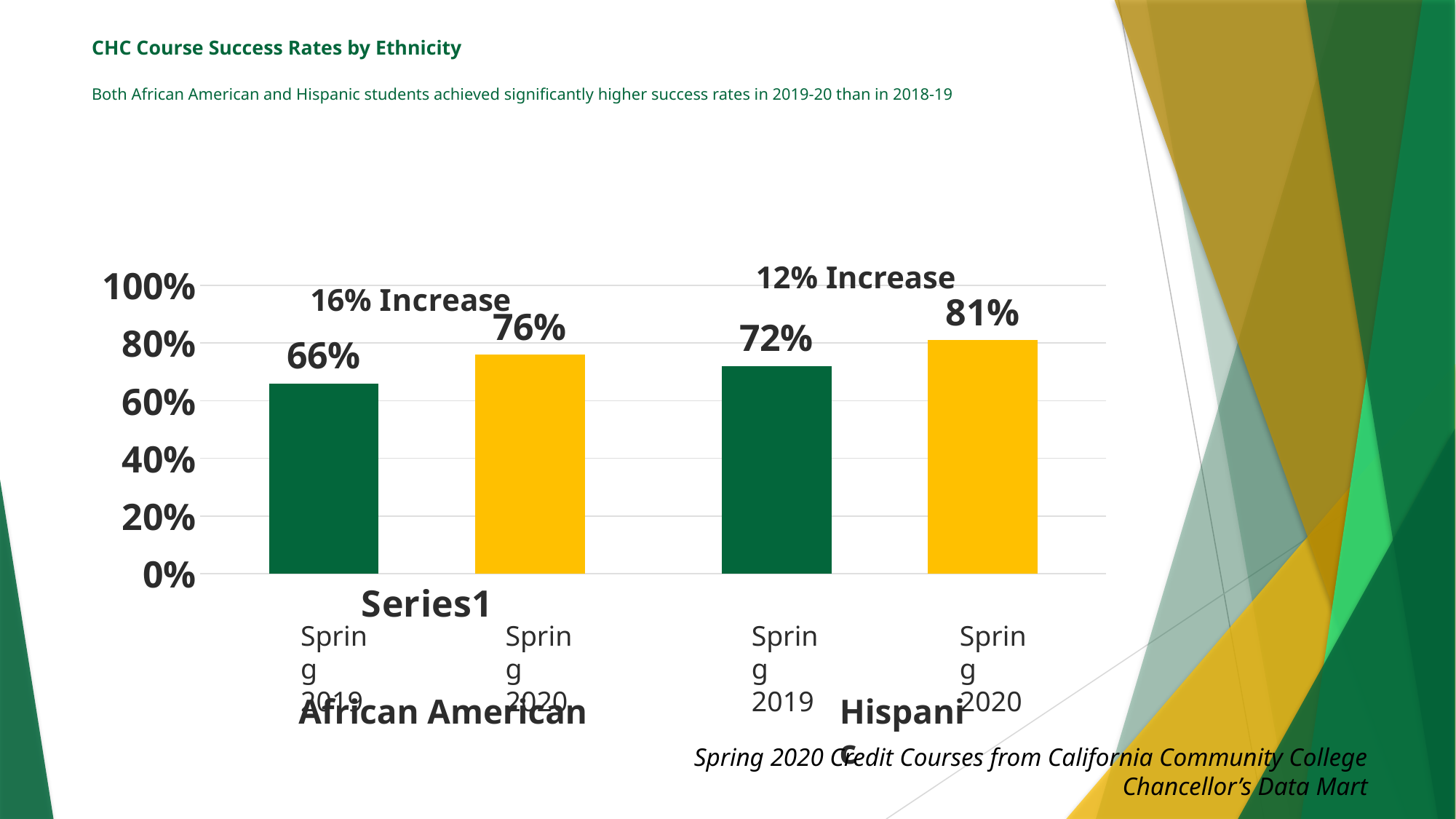
Which bar shows the highest success rate? Hispanic Spring 2020 How many bars are plotted in the chart? 4 What is the difference in percentage points between the African American Spring 2020 rate and the African American Spring 2019 rate? 10 What is the difference in percentage points between the Hispanic Spring 2020 rate and the Hispanic Spring 2019 rate? 9 What is the course success rate for African American students in Spring 2020? 76% What increase is annotated above the African American bars? 16% Increase What kind of chart is shown on the slide? Bar chart What is the course success rate for Hispanic students in Spring 2019? 72% What is the course success rate for African American students in Spring 2019? 66% Which is larger: the Spring 2019 rate for African American students or the Spring 2019 rate for Hispanic students? Hispanic Spring 2019 Which bar shows the lowest success rate? African American Spring 2019 What is the course success rate for Hispanic students in Spring 2020? 81%